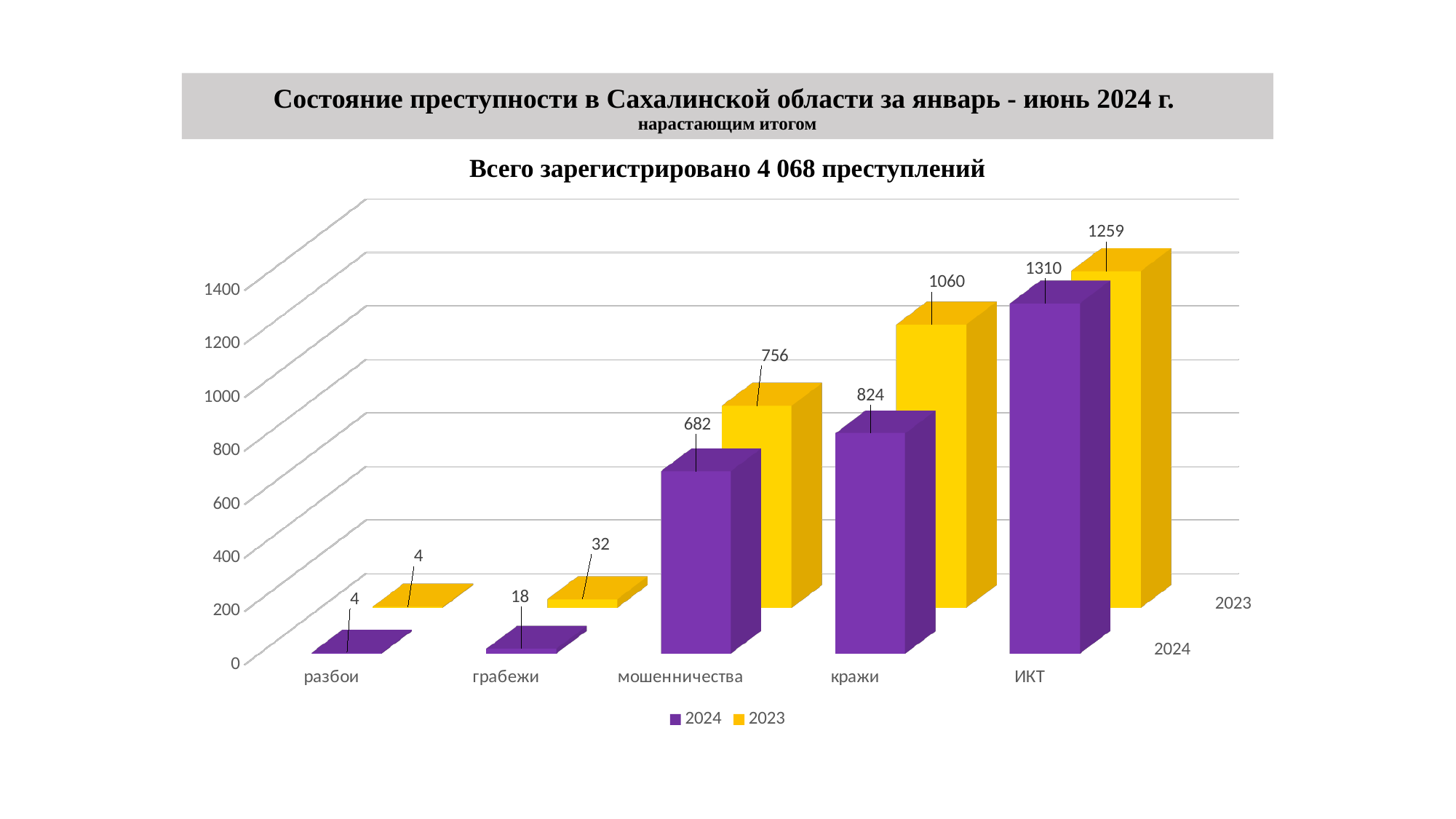
For ИКТ, which series has the larger value, 2024 or 2023? 2024 What is the value for грабежи in the 2023 series? 32 What is the value for ИКТ in the 2024 series? 1310 Which category has the highest value in the 2024 series? ИКТ Which category has the lowest value in the 2023 series? разбои What is the difference between the 2023 and 2024 values for кражи? 236 What is the value for кражи in the 2023 series? 1060 What is the value for мошенничества in the 2024 series? 682 How many series does the legend list? 2 What kind of chart is shown on the slide? Bar chart How many categories are shown on the x axis? 5 What total number of registered crimes is stated in the chart title? 4 068